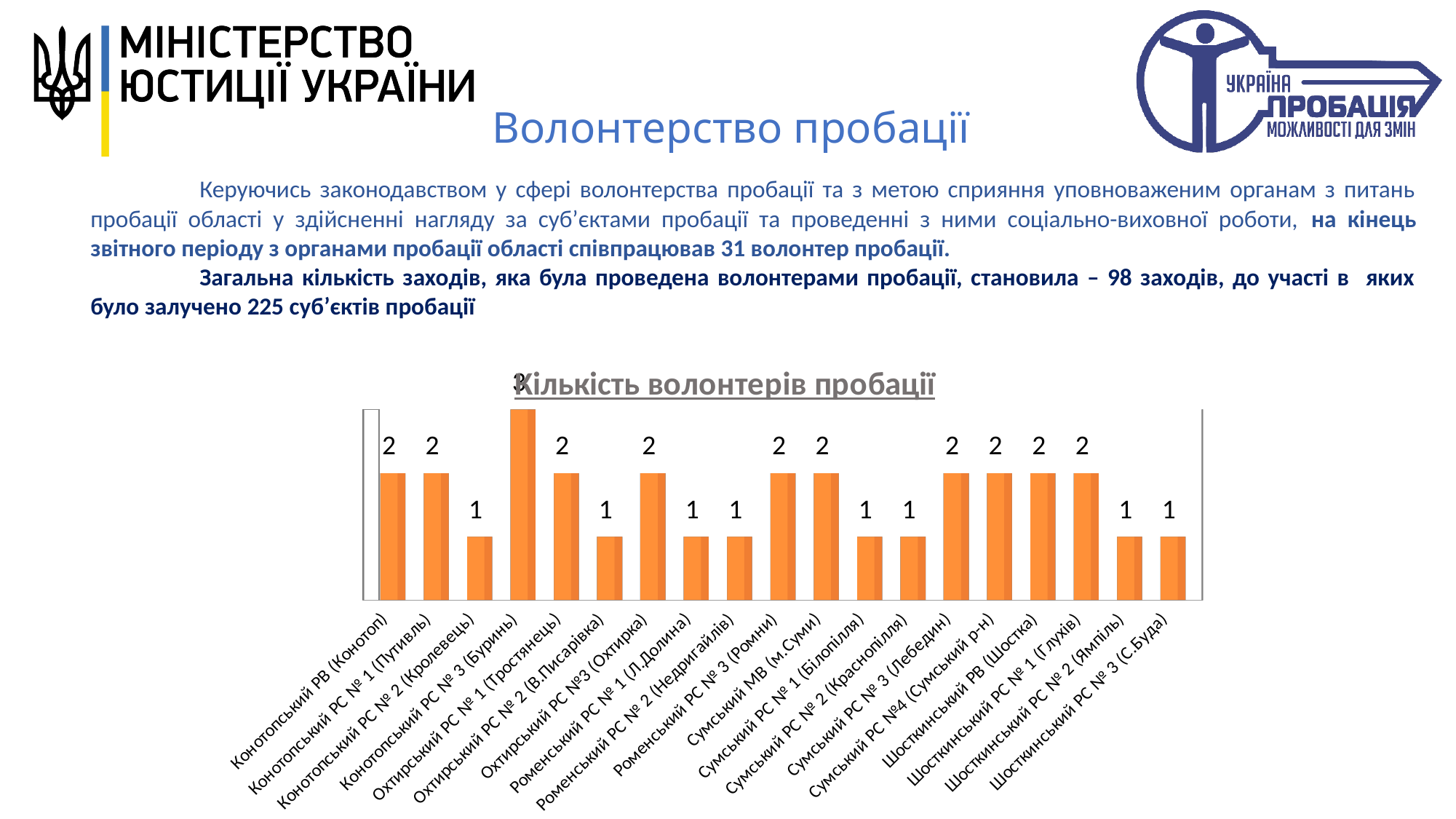
How many categories are shown on the x axis of the chart? 19 What colour are the bars in the chart? orange What is the value for Сумський МВ (м.Суми)? 2 What is the title of the chart? Кількість волонтерів пробації Which category has the highest number of volunteers? Конотопський РС № 3 (Буринь) Which is larger, the value for Роменський РС № 3 (Ромни) or the value for Роменський РС № 1 (Л.Долина)? Роменський РС № 3 (Ромни) What is the value for Конотопський РС № 2 (Кролевець)? 1 What is the value for Сумський РС № 4 (Сумський р-н)? 2 What is the difference between the values for Охтирський РС № 1 (Тростянець) and Охтирський РС № 2 (В.Писарівка)? 1 What kind of chart is shown on the slide? bar chart What is the value for Конотопський РВ (Конотоп)? 2 What is the value for Шосткинський РС № 3 (С.Буда)? 1